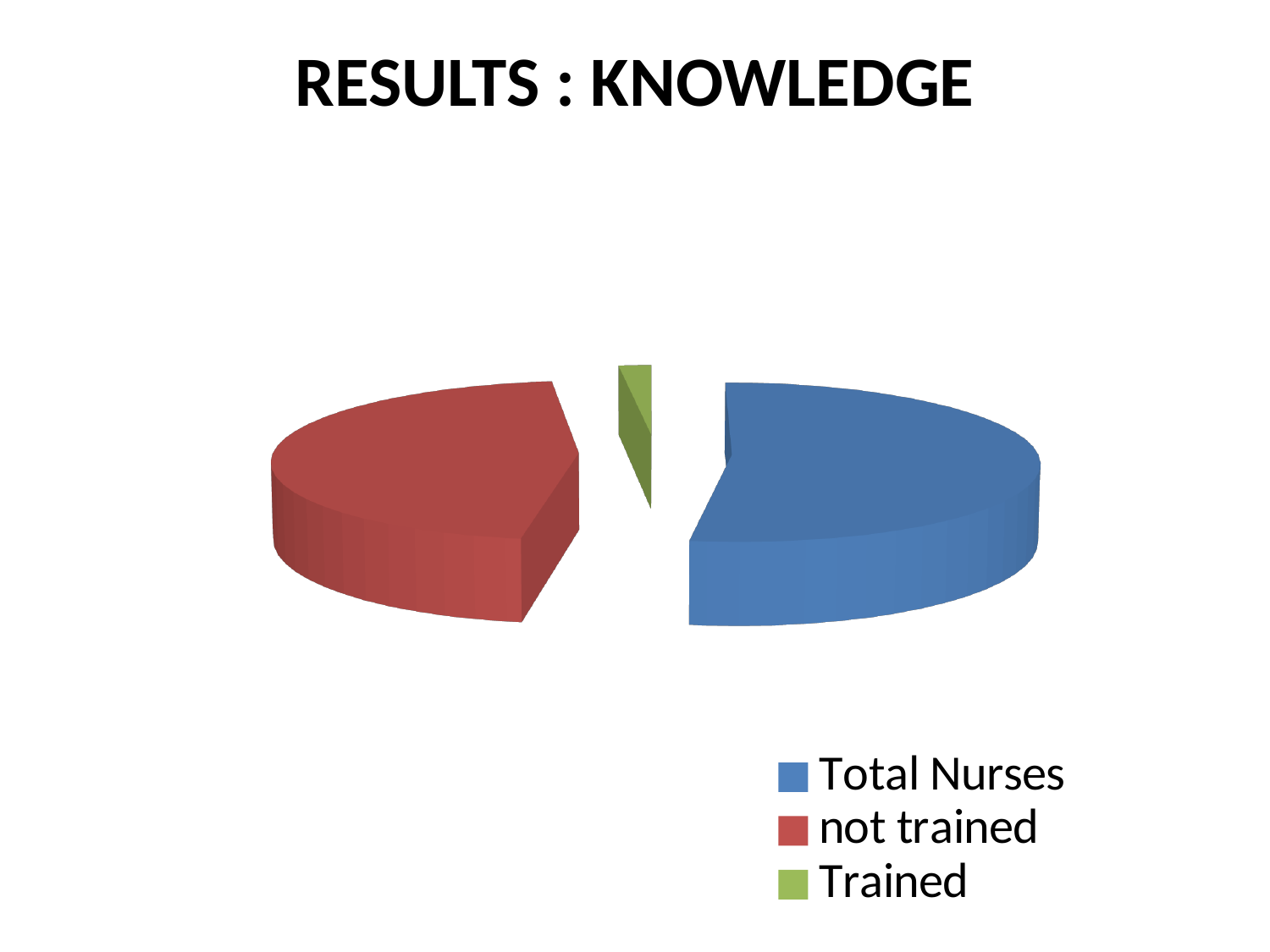
Which is larger in the pie chart, the 'Trained' slice or the 'Total Nurses' slice? Total Nurses Which legend entry is shown in red in the pie chart? not trained How many slices does the pie chart have? 3 Which colour represents 'Trained' in the pie chart? green What kind of chart is shown on the slide? pie chart Which is larger in the pie chart, the 'Trained' slice or the 'not trained' slice? not trained Which slice of the pie chart is the smallest? Trained What is the title of the slide containing the pie chart? RESULTS : KNOWLEDGE How many entries does the legend of the pie chart list? 3